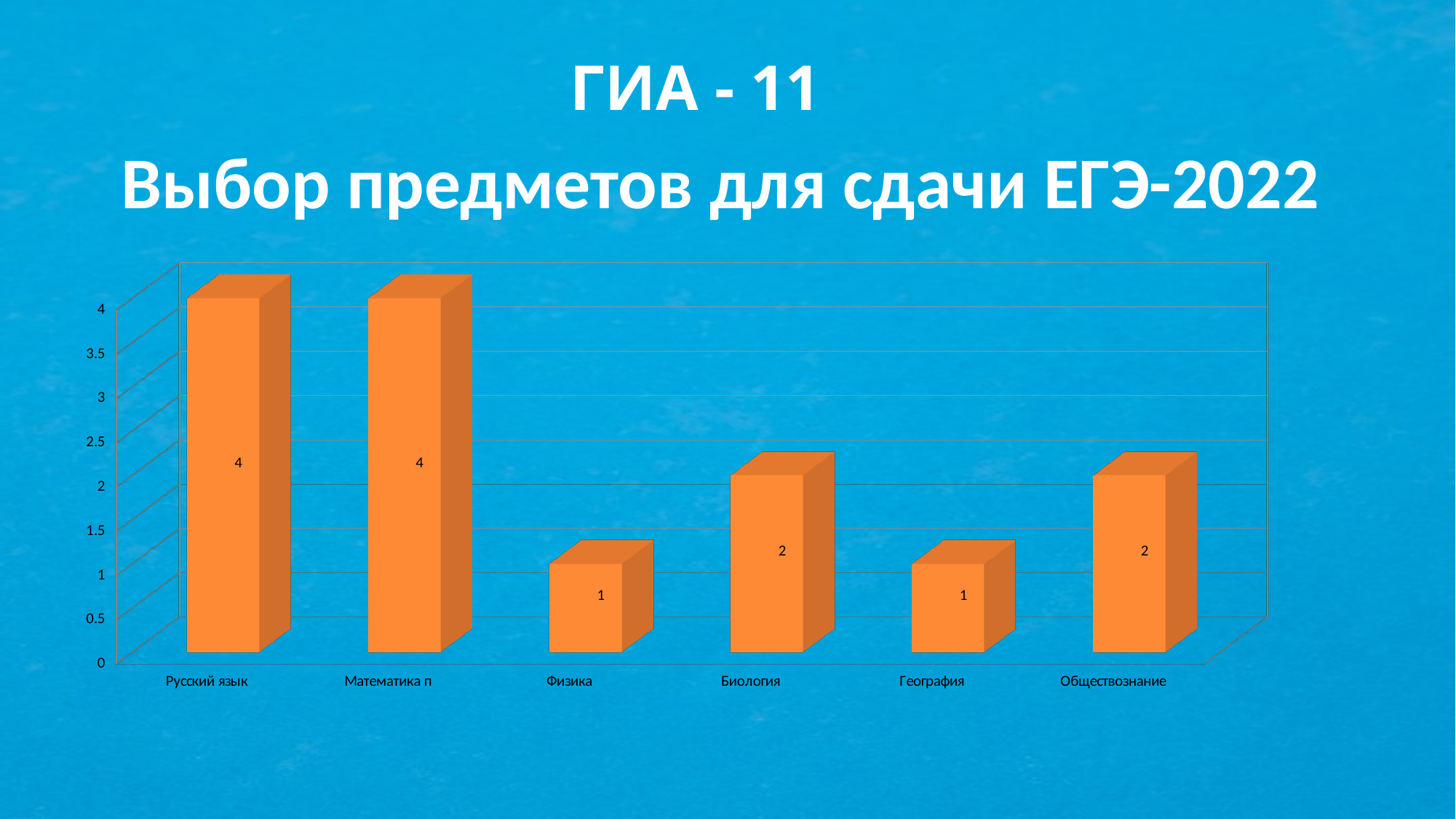
What is the value for Физика? 1 What is the difference between the values for Математика п and Физика? 3 Is the value for Русский язык larger than the value for Биология? Yes What kind of chart is shown on the slide? Bar chart What is the value for Русский язык? 4 What is the difference between the values for Обществознание and География? 1 What colour are the bars in the chart? Orange What is the title of the slide? ГИА - 11 Выбор предметов для сдачи ЕГЭ-2022 What is the value for Биология? 2 What is the value for Обществознание? 2 Which category has the lowest value, Биология or География? География How many categories are shown on the x axis? 6